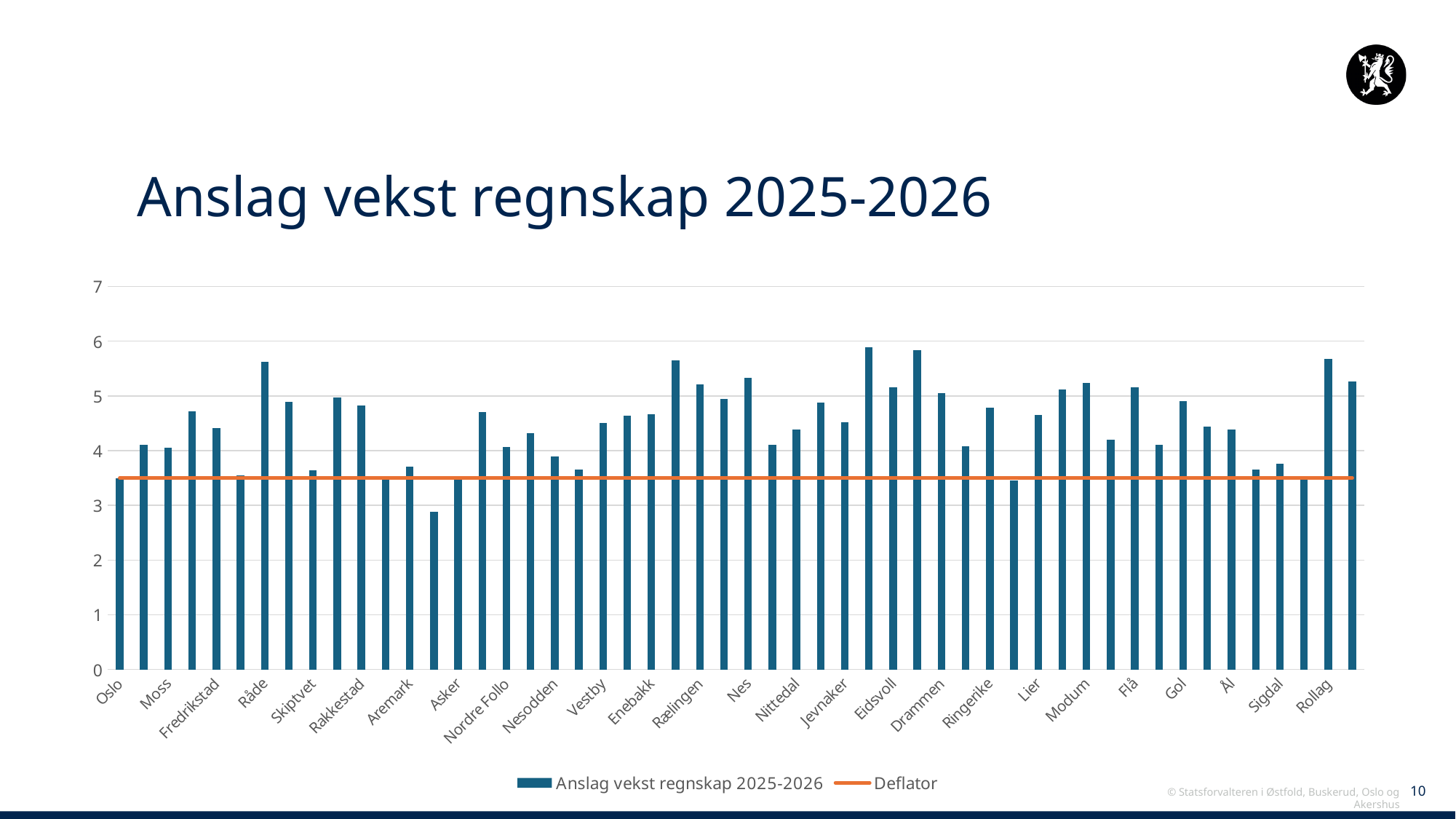
How many series does the legend list? 2 Which has the larger value, Rollag or Sigdal? Rollag Is the value for Sigdal greater or less than 4? less What kind of chart is shown on the slide? combination bar and line chart Is the value for Nesodden greater or less than 4? less What is the title of the chart? Anslag vekst regnskap 2025-2026 What is the name of the series drawn as an orange horizontal line? Deflator Which has the larger value, Nes or Nittedal? Nes Is the value for Fredrikstad greater or less than 5? less Which has the larger value, Råde or Skiptvet? Råde